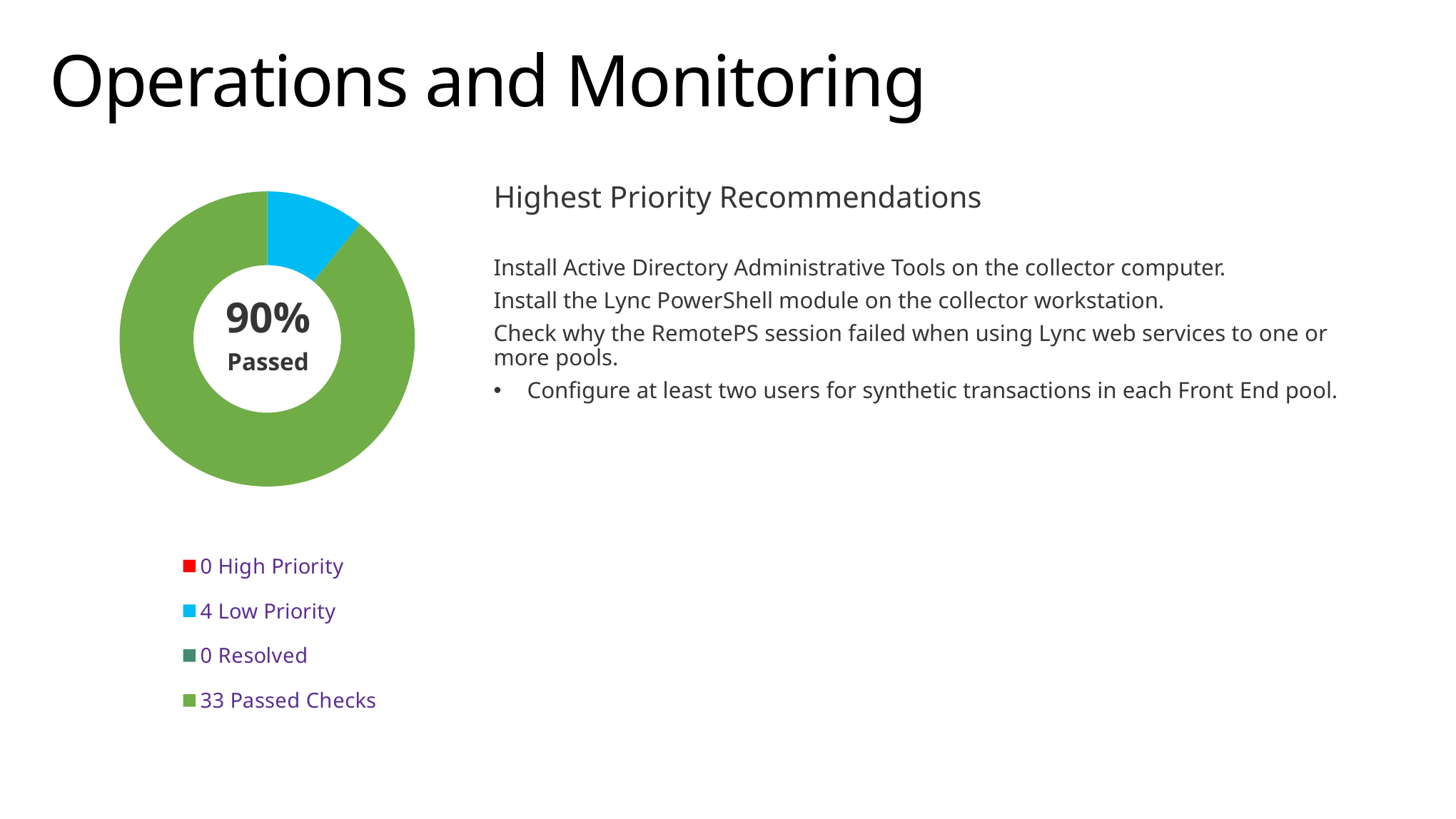
What word appears below the percentage in the centre of the doughnut chart? Passed What percentage is shown in the centre of the doughnut chart? 90% Which category has the highest value in the chart? Passed Checks Which is larger, the number of Passed Checks or the number of Low Priority items? Passed Checks What colour represents Passed Checks in the chart? Green What kind of chart is shown on the slide? Doughnut chart How many Low Priority items does the legend show? 4 What is the difference between the number of Passed Checks and the number of Low Priority items? 29 How many High Priority items does the legend show? 0 How many Passed Checks does the legend show? 33 How many categories does the legend list? 4 How many Resolved items does the legend show? 0